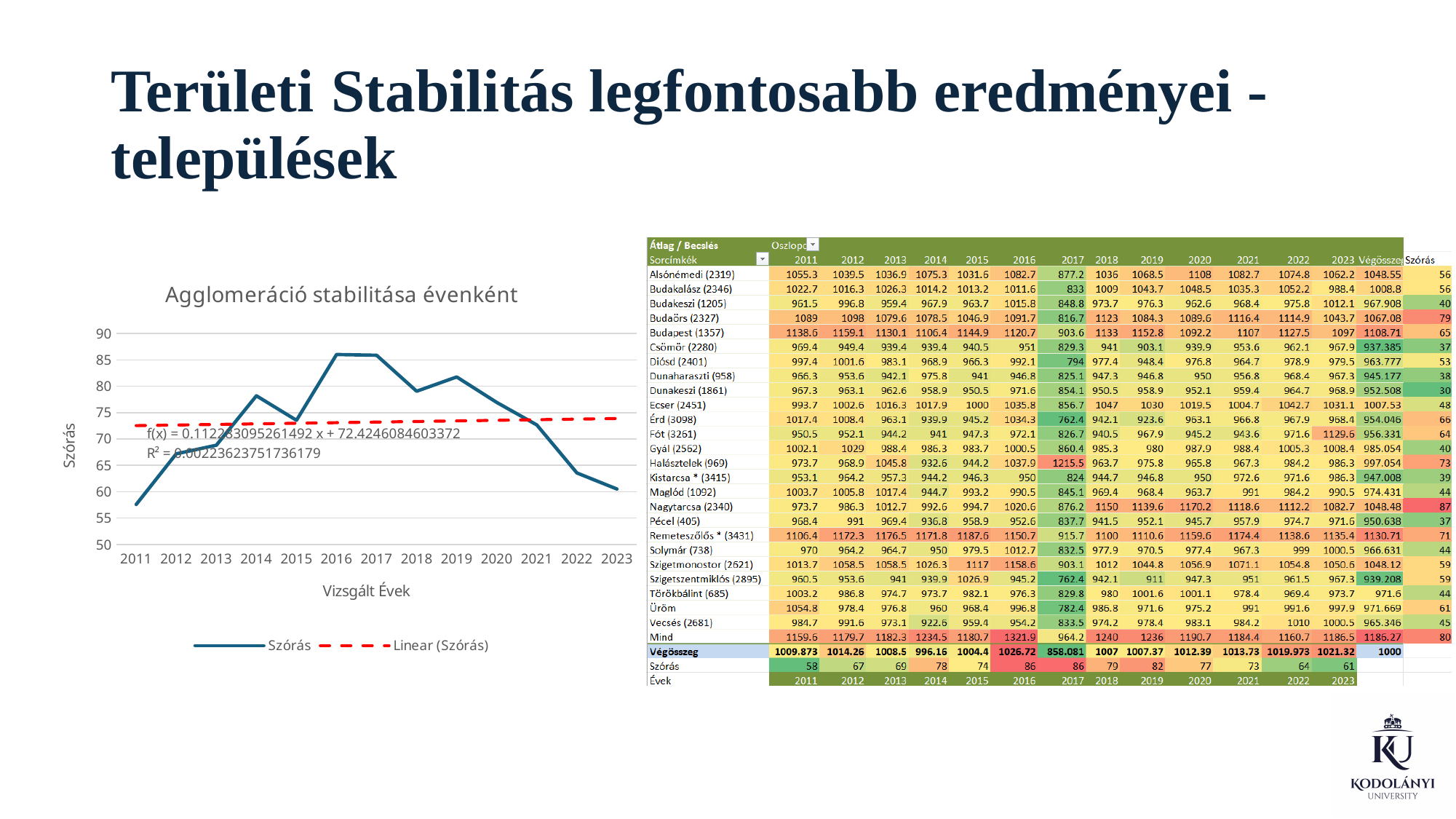
What kind of chart is 'Agglomeráció stabilitása évenként'? line chart What is the x-axis title of the 'Agglomeráció stabilitása évenként' chart? Vizsgált Évek In the 'Agglomeráció stabilitása évenként' chart, which year has the larger Szórás value, 2014 or 2015? 2014 In the 'Agglomeráció stabilitása évenként' chart, which year has the lowest Szórás value? 2011 In the 'Agglomeráció stabilitása évenként' chart, is the Szórás value for 2016 greater or less than 85? greater In the 'Agglomeráció stabilitása évenként' chart, is the Szórás value for 2019 greater or less than 80? greater In the 'Agglomeráció stabilitása évenként' chart, what colour is the 'Linear (Szórás)' trendline? red How many years are plotted on the x axis of the 'Agglomeráció stabilitása évenként' chart? 13 How many entries does the legend of the 'Agglomeráció stabilitása évenként' chart list? 2 In the 'Agglomeráció stabilitása évenként' chart, is the Szórás value for 2011 greater or less than 60? less In the 'Agglomeráció stabilitása évenként' chart, do the Szórás values rise or fall from 2019 to 2023? fall